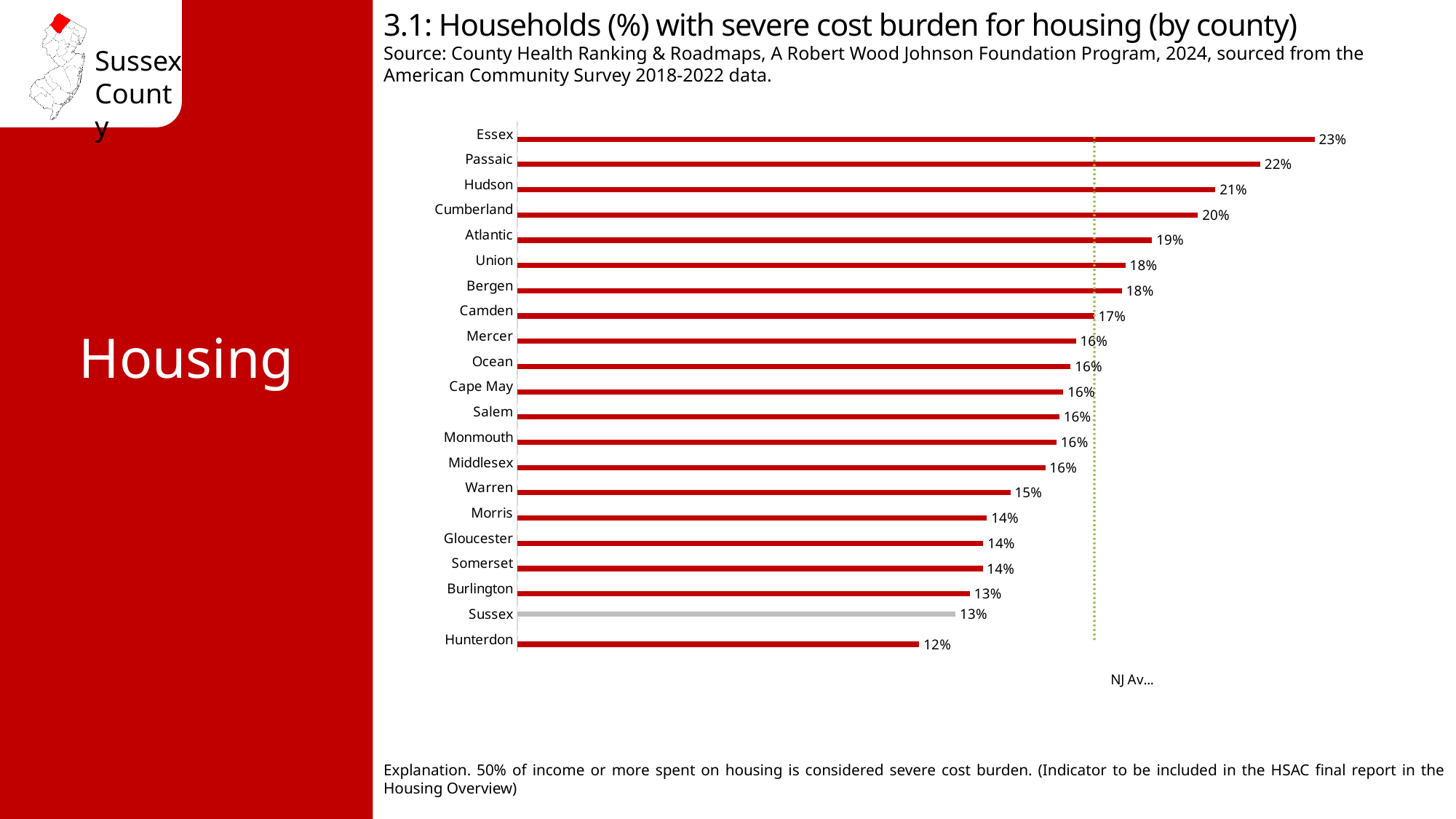
What is the difference between the values for Essex and Sussex? 10 percentage points What is the value for Warren County? 15% Which county's bar is drawn in grey instead of red? Sussex How many counties are shown in the chart? 21 Which has a higher value, Passaic or Hudson? Passaic Which has a higher value, Atlantic or Camden? Atlantic What kind of chart is shown on the slide? Bar chart What is the difference between the values for Cumberland and Hunterdon? 8 percentage points Which county has the highest percentage of households with severe cost burden for housing? Essex What is the value for Essex County? 23% What is the value for Sussex County? 13% Which county has the lowest percentage of households with severe cost burden for housing? Hunterdon